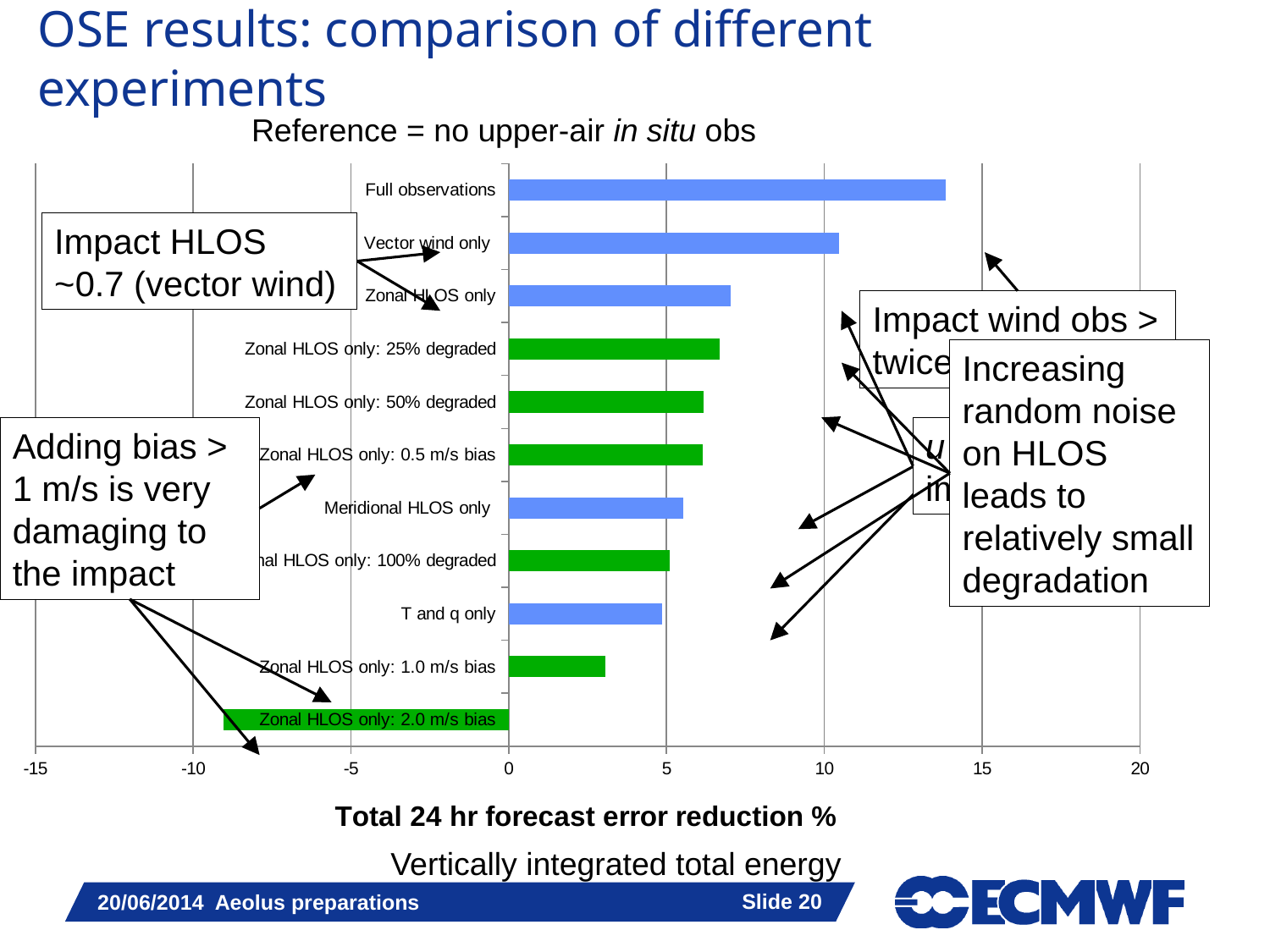
Which is larger, the value for Full observations or the value for Vector wind only? Full observations What is the title of the horizontal axis of the chart? Total 24 hr forecast error reduction % Is the value for Zonal HLOS only: 2.0 m/s bias greater or less than -5? less Which category has the highest value in the chart? Full observations Which is larger, the value for T and q only or the value for Zonal HLOS only: 1.0 m/s bias? T and q only Is the value for Zonal HLOS only greater or less than 10? less How many bars in the chart have a negative value? 1 Which category has the lowest value in the chart? Zonal HLOS only: 2.0 m/s bias What kind of chart is shown on the slide? bar chart How many categories (bars) does the chart show? 11 Is the value for Full observations greater or less than 10? greater